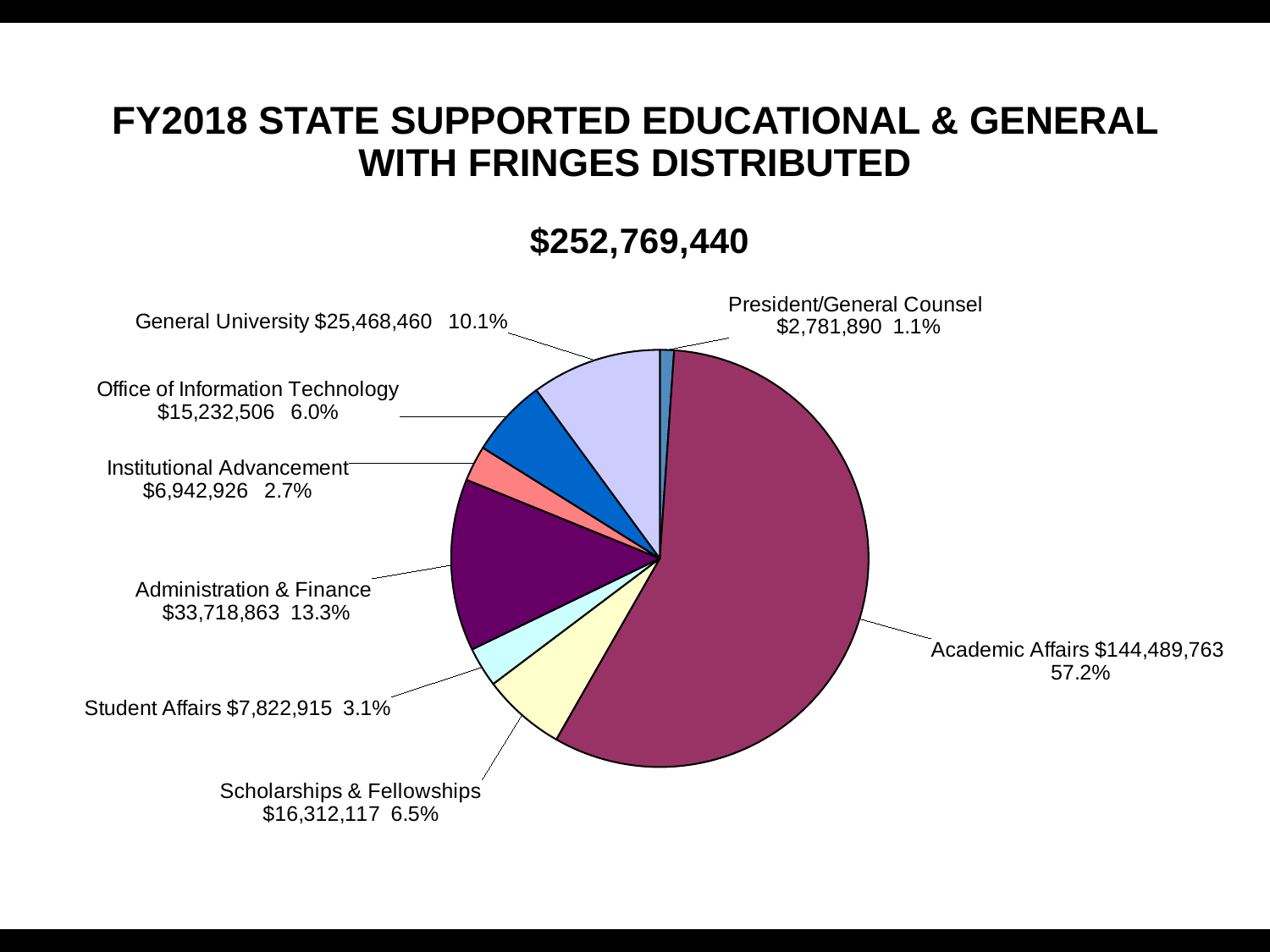
What is the dollar value for Institutional Advancement? $6,942,926 Which is larger, General University or Scholarships & Fellowships? General University How many categories are shown in the pie chart? 8 What is the dollar value for Academic Affairs? $144,489,763 What is the dollar value for Office of Information Technology? $15,232,506 What percentage share does Student Affairs have? 3.1% Which category has the largest slice of the pie? Academic Affairs Which category has the smallest slice of the pie? President/General Counsel What total amount is shown below the chart title? $252,769,440 What percentage share does Administration & Finance have? 13.3% What is the difference in percentage share between General University and Office of Information Technology? 4.1% What kind of chart is shown on the slide? Pie chart